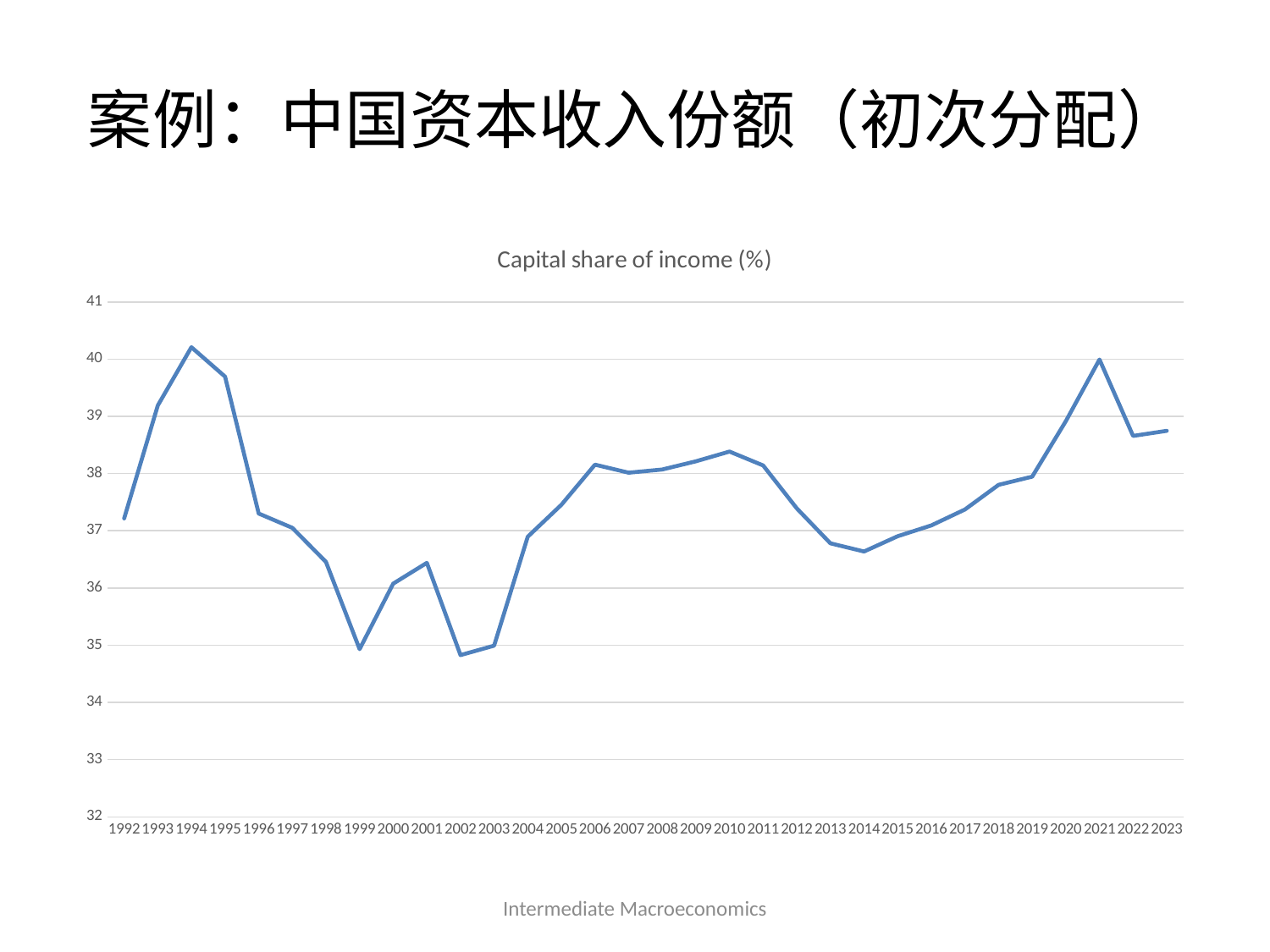
Is the value for 2014 greater or less than 37? less Is the value for 1998 greater or less than 37? less What is the title of the chart? Capital share of income (%) Is the value for 2022 greater or less than 39? less What kind of chart is shown on the slide? line chart How many years (data points) are plotted along the x axis? 32 Does the capital share of income rise or fall from 1994 to 1999? fall Does the capital share of income rise or fall from 2014 to 2021? rise Which is larger, the value for 1994 or the value for 1999? 1994